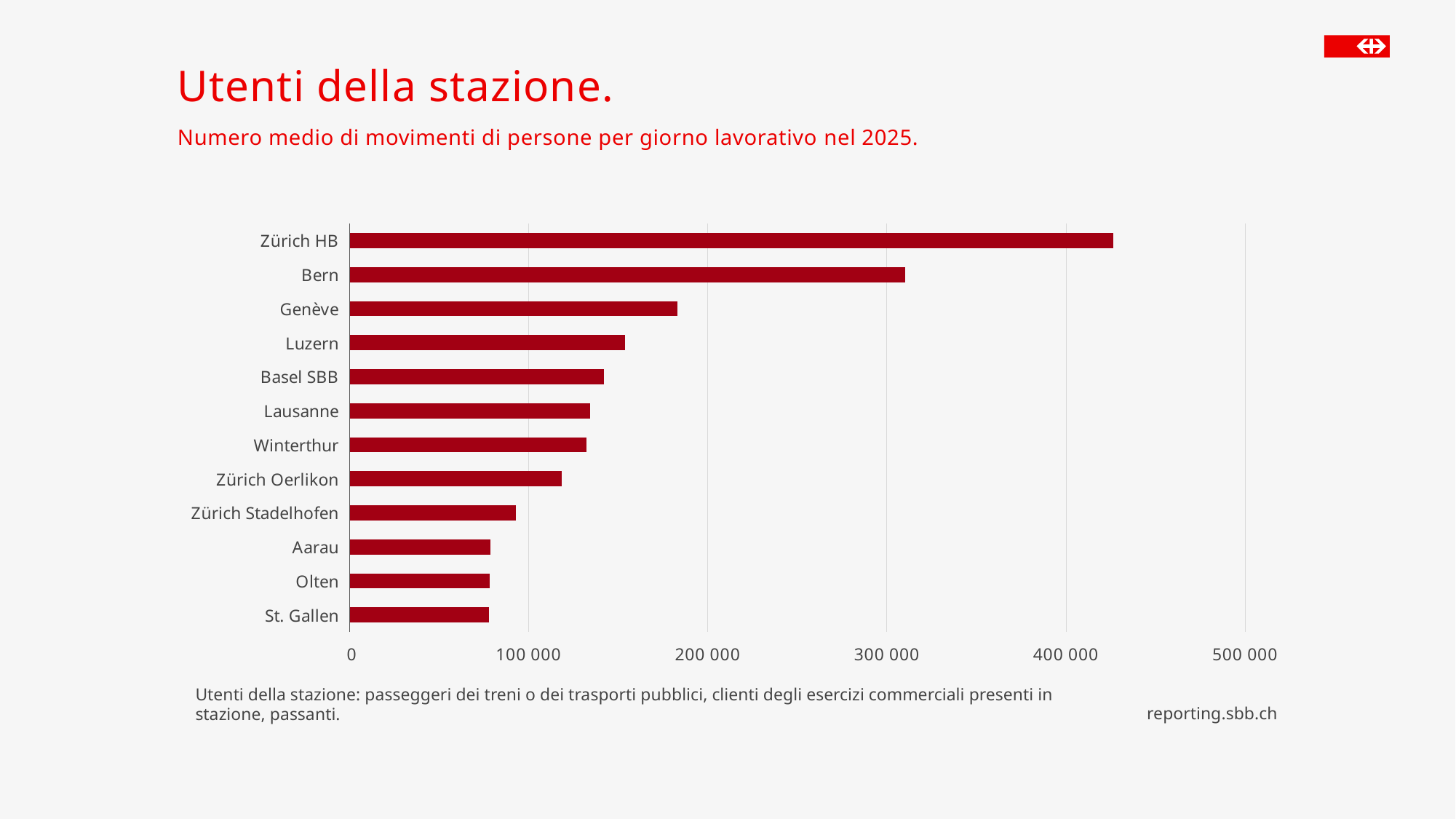
What is the highest value shown on the x axis? 500 000 Is the value for Zürich Stadelhofen greater or less than 100 000? less Which has more station users, Bern or Genève? Bern Is the value for Zürich Oerlikon greater or less than 100 000? greater Is the value for Genève greater or less than 200 000? less Which has more station users, Luzern or Basel SBB? Luzern Which station has the highest number of station users? Zürich HB How many stations are shown in the chart? 12 What kind of chart is shown on the slide? Bar chart What is the title of the slide? Utenti della stazione.